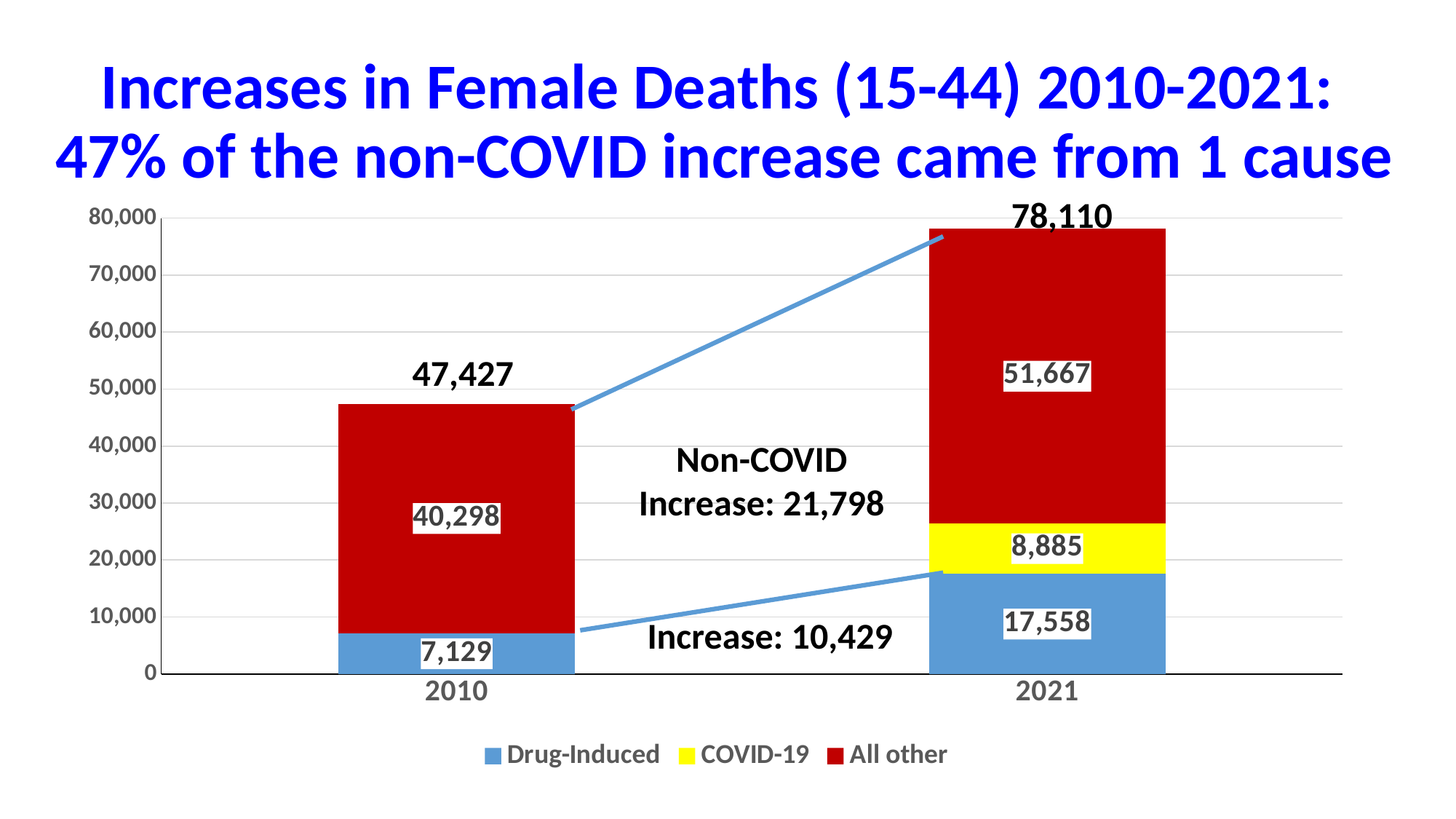
What kind of chart is shown on the slide? Stacked bar chart What is the Drug-Induced value for 2010? 7,129 What is the total of the stacked bar for 2021? 78,110 What is the difference between the Drug-Induced values for 2021 and 2010? 10,429 What is the Drug-Induced value for 2021? 17,558 What is the COVID-19 value for 2021? 8,885 What is the All other value for 2021? 51,667 What is the total of the stacked bar for 2010? 47,427 How many series does the legend list? 3 How many categories are shown on the x axis? 2 Which colour represents COVID-19 in the chart? Yellow Which year has the higher All other value, 2010 or 2021? 2021